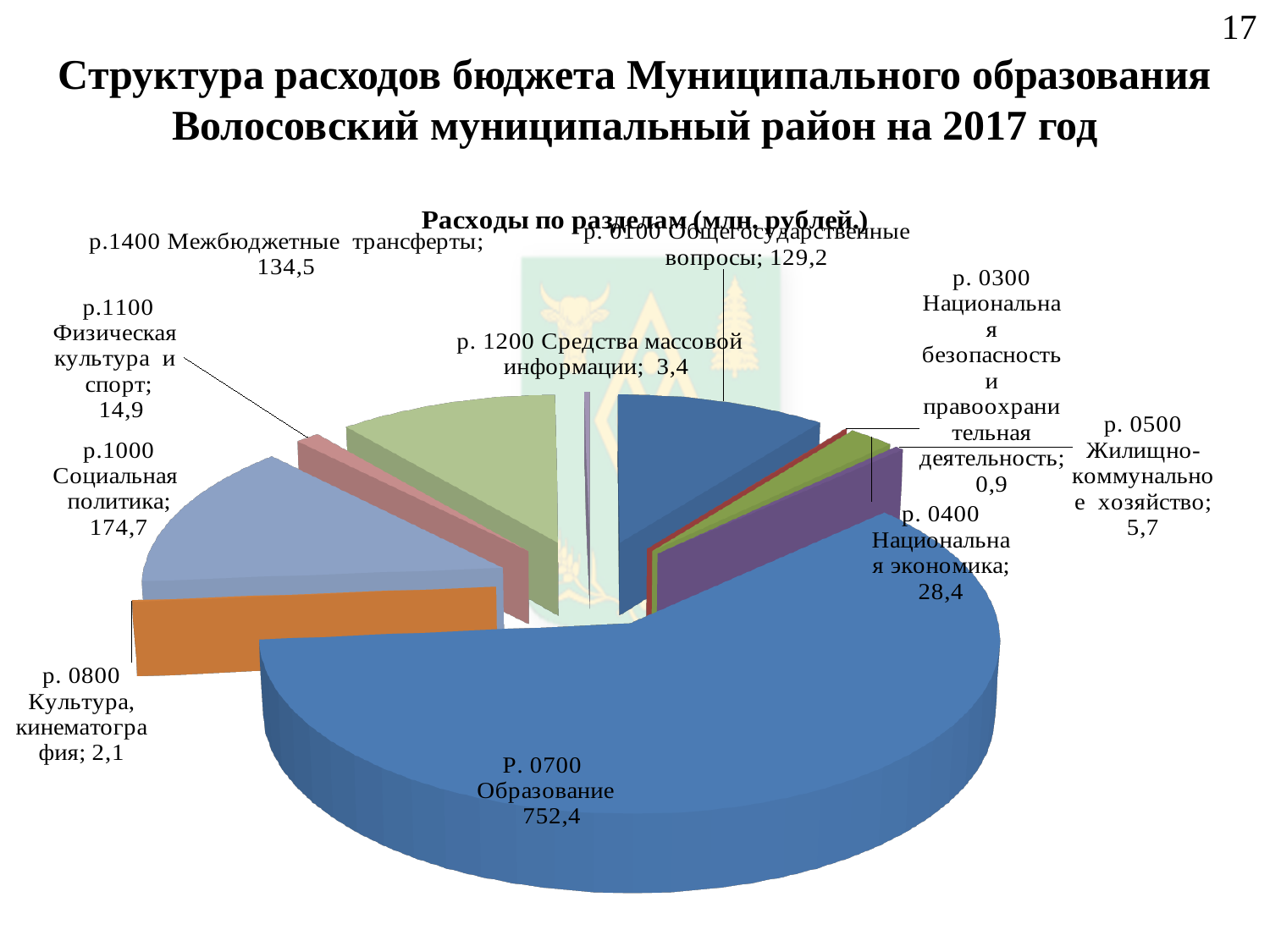
What is the value for "Р. 0700 Образование" in the pie chart? 752,4 What is the difference between "р.1000 Социальная политика" and "р.1400 Межбюджетные трансферты"? 40,2 Which is larger: "р. 0100 Общегосударственные вопросы" or "р.1400 Межбюджетные трансферты"? р.1400 Межбюджетные трансферты How many sections (slices) are shown in the pie chart? 10 What is the value for "р.1000 Социальная политика"? 174,7 What is the title of the pie chart? Расходы по разделам (млн. рублей.) Which section has the largest expenditure in the pie chart? Р. 0700 Образование What is the value for "р. 1200 Средства массовой информации"? 3,4 What is the value for "р. 0400 Национальная экономика"? 28,4 What type of chart is shown on the slide? Pie chart Which section has the smallest expenditure in the pie chart? р. 0300 Национальная безопасность и правоохранительная деятельность What is the value for "р.1400 Межбюджетные трансферты"? 134,5